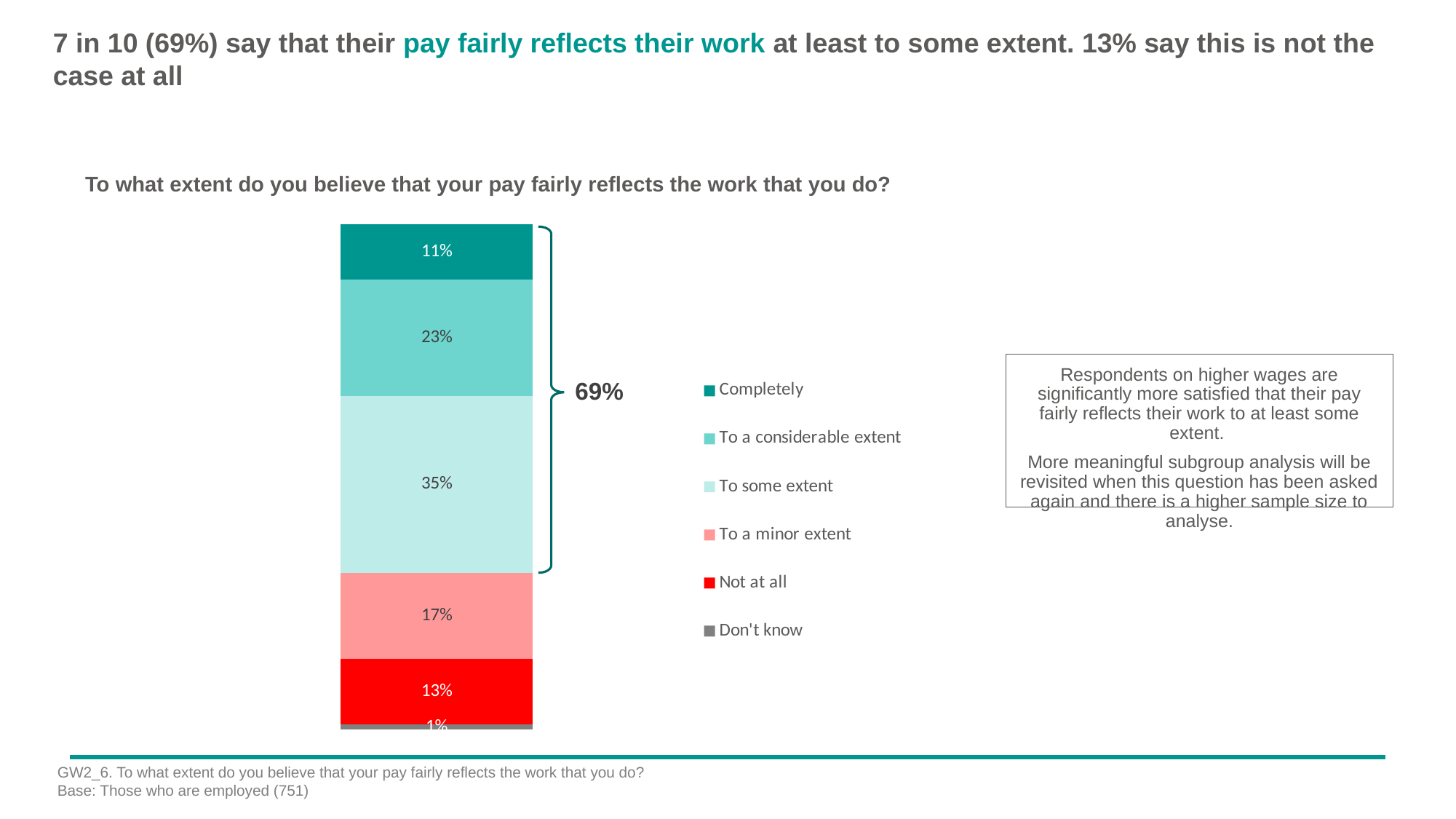
What percentage of respondents answered 'To a minor extent'? 17% What percentage of respondents answered 'Completely'? 11% How many response categories does the legend list? 6 What percentage of respondents answered 'Not at all'? 13% What is the difference in percentage points between 'To some extent' and 'To a considerable extent'? 12 Which response category has the smallest share of respondents? Don't know What colour is the 'Not at all' segment of the bar? Red What type of chart is shown on the slide? Stacked bar chart What percentage of respondents say their pay reflects their work 'To some extent'? 35% Which response category has the largest share of respondents? To some extent What combined percentage is indicated by the bracket next to the top three segments of the bar? 69% Which is larger: the share answering 'To a minor extent' or the share answering 'Not at all'? To a minor extent